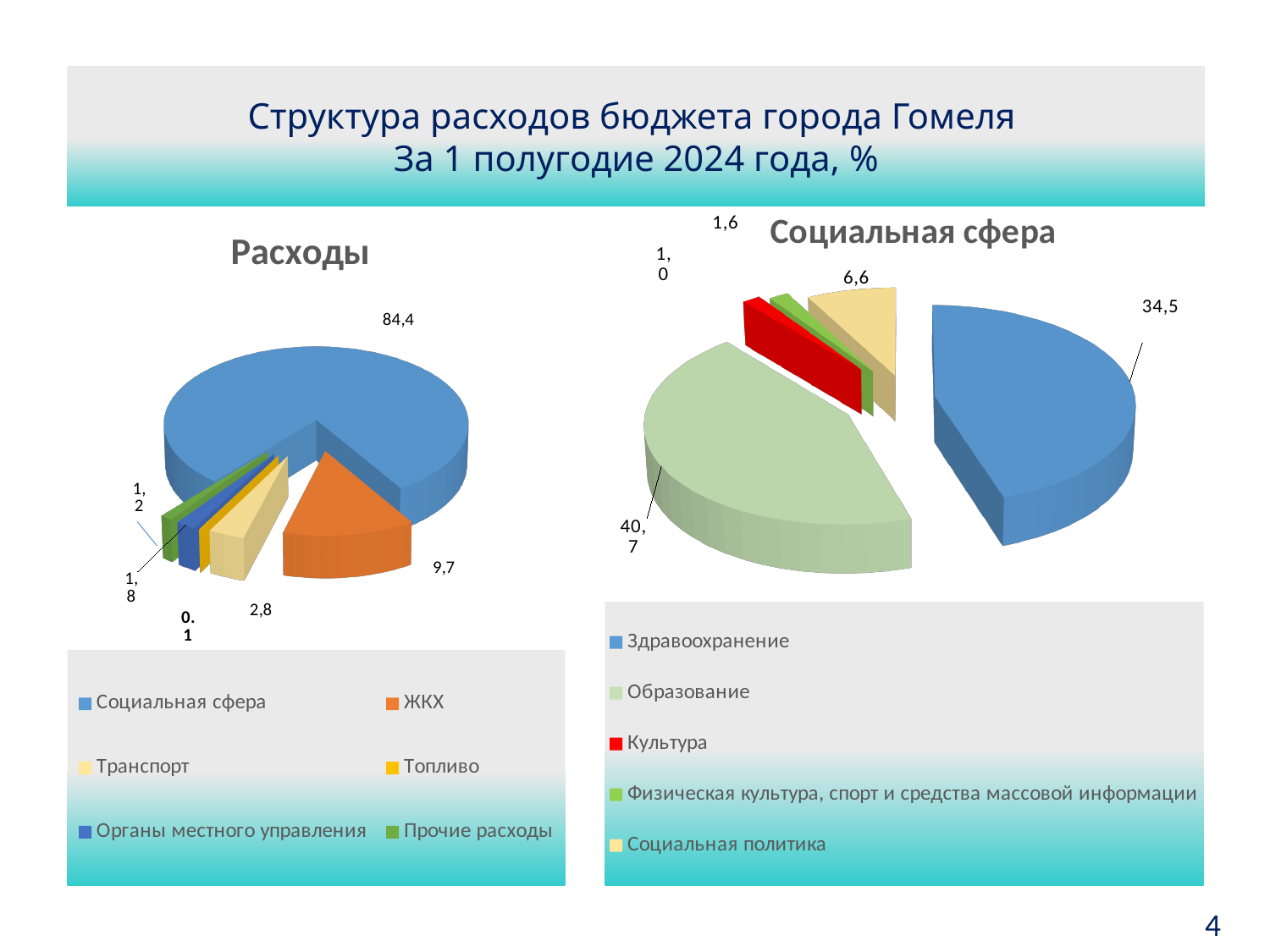
In the "Социальная сфера" chart, what is the value for Здравоохранение? 34,5 In the "Расходы" chart, what is the value for Транспорт? 2,8 In the "Расходы" chart, what is the value for Социальная сфера? 84,4 In the "Расходы" chart, which category has the smallest share? Топливо In the "Социальная сфера" chart, which is larger: Образование or Здравоохранение? Образование In the "Социальная сфера" chart, what is the value for Социальная политика? 6,6 In the "Социальная сфера" chart, what is the value for Образование? 40,7 What kind of chart is the "Расходы" chart on the left? Pie chart In the "Расходы" chart, what is the value for ЖКХ? 9,7 In the "Расходы" chart, what is the difference between the values for ЖКХ and Транспорт? 6,9 How many categories does the legend of the "Расходы" chart list? 6 In the "Расходы" chart, which category has the largest share? Социальная сфера